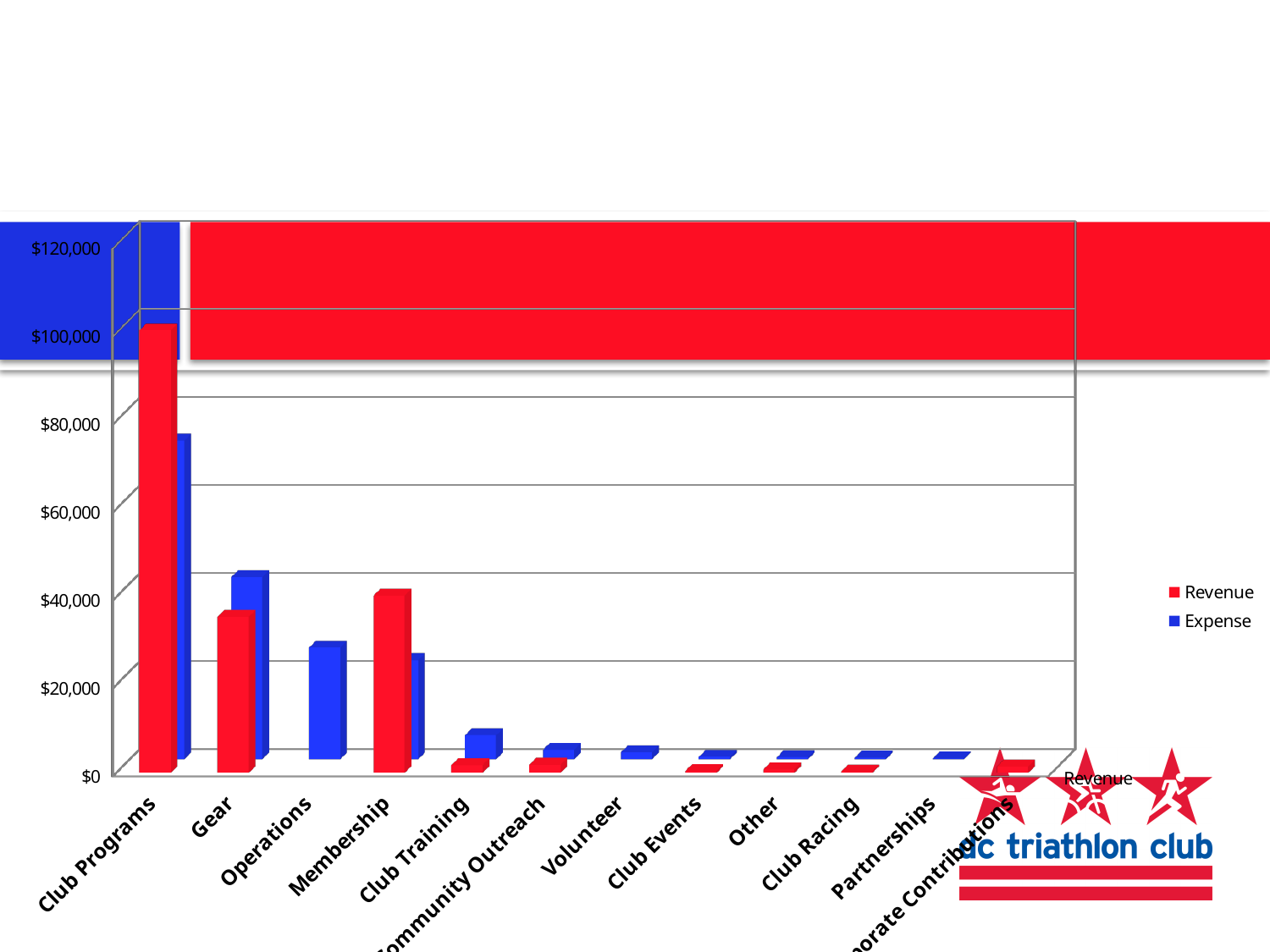
Which category has the highest Expense? Club Programs Which colour represents the Expense series? blue Is the Expense value for Club Programs greater or less than $80,000? less What kind of chart is shown on the slide? bar chart Which category has the highest Revenue? Club Programs Is the Expense value for Operations greater or less than $20,000? greater For Gear, which is larger, Revenue or Expense? Expense Which colour represents the Revenue series? red For Membership, which is larger, Revenue or Expense? Revenue How many series does the legend list? 2 Is the Revenue value for Club Programs greater or less than $80,000? greater